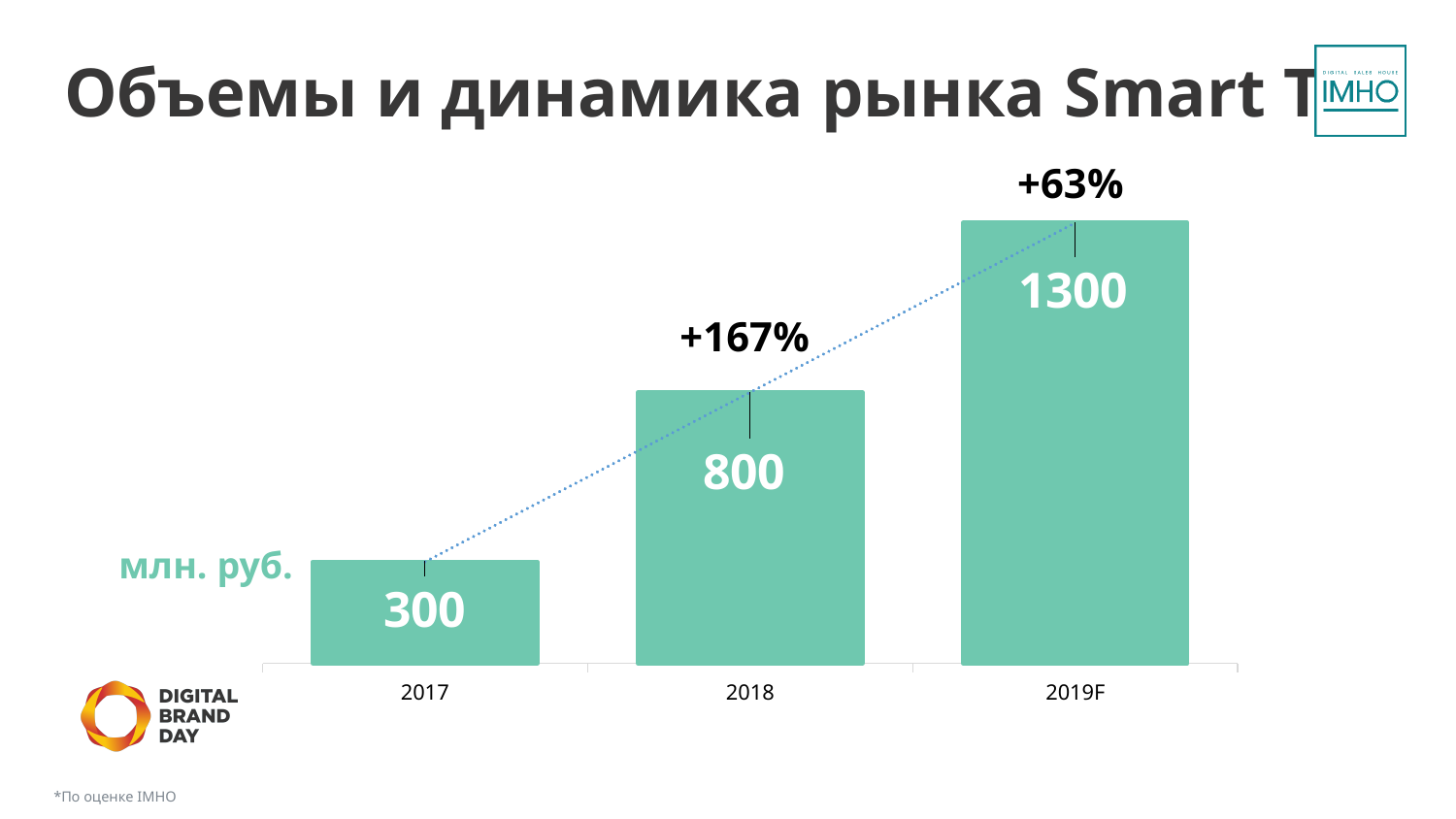
What is the difference between the values for 2018 and 2017? 500 What growth percentage is shown above the 2018 bar? +167% How many years are shown on the x axis? 3 Do the values rise or fall from 2017 to 2019F? rise What kind of chart is shown on the slide? bar chart What is the value for 2017? 300 What is the difference between the values for 2019F and 2018? 500 Which year has the highest value? 2019F Which is larger, the value for 2018 or the value for 2017? 2018 Which year has the lowest value? 2017 What is the value for 2018? 800 What is the value for 2019F? 1300